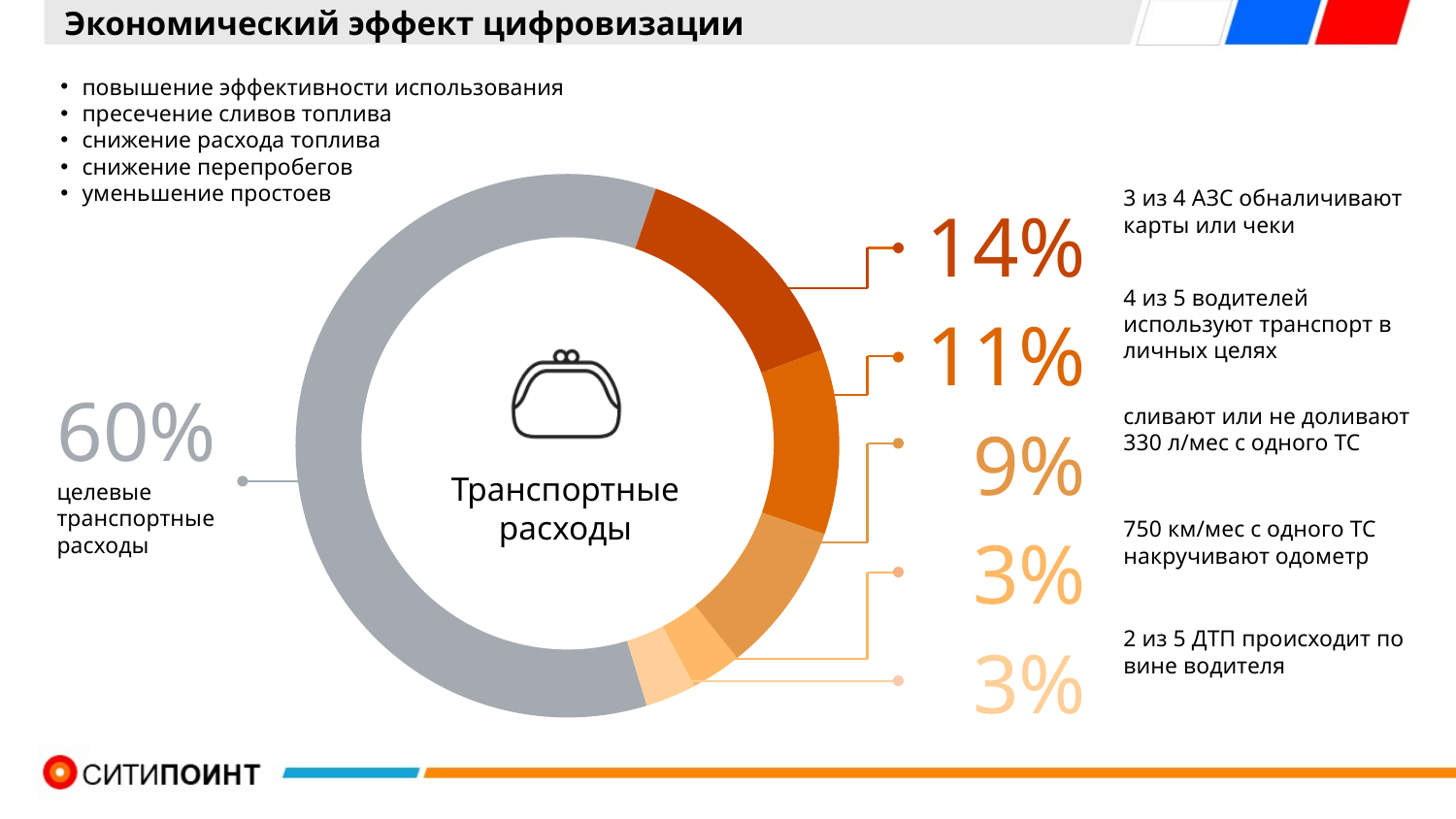
Which is larger: the segment for '4 из 5 водителей используют транспорт в личных целях' or the segment for 'сливают или не доливают 330 л/мес с одного ТС'? 4 из 5 водителей используют транспорт в личных целях (11%) How many segments does the donut chart have? 6 What percentage is shown for the segment described as '4 из 5 водителей используют транспорт в личных целях'? 11% Which segment of the donut chart is the largest? целевые транспортные расходы (60%) What is the combined share of all the orange (non-grey) segments of the donut chart? 40% What kind of chart is shown on the slide? Donut (pie) chart What share of the donut chart is labelled 'целевые транспортные расходы'? 60% What is the title shown in the centre of the donut chart? Транспортные расходы What percentage is shown for the segment described as 'сливают или не доливают 330 л/мес с одного ТС'? 9% What percentage is shown for the segment described as '750 км/мес с одного ТС накручивают одометр'? 3% What percentage is shown for the segment described as '3 из 4 АЗС обналичивают карты или чеки'? 14% What is the difference between the 14% segment and the 11% segment? 3%